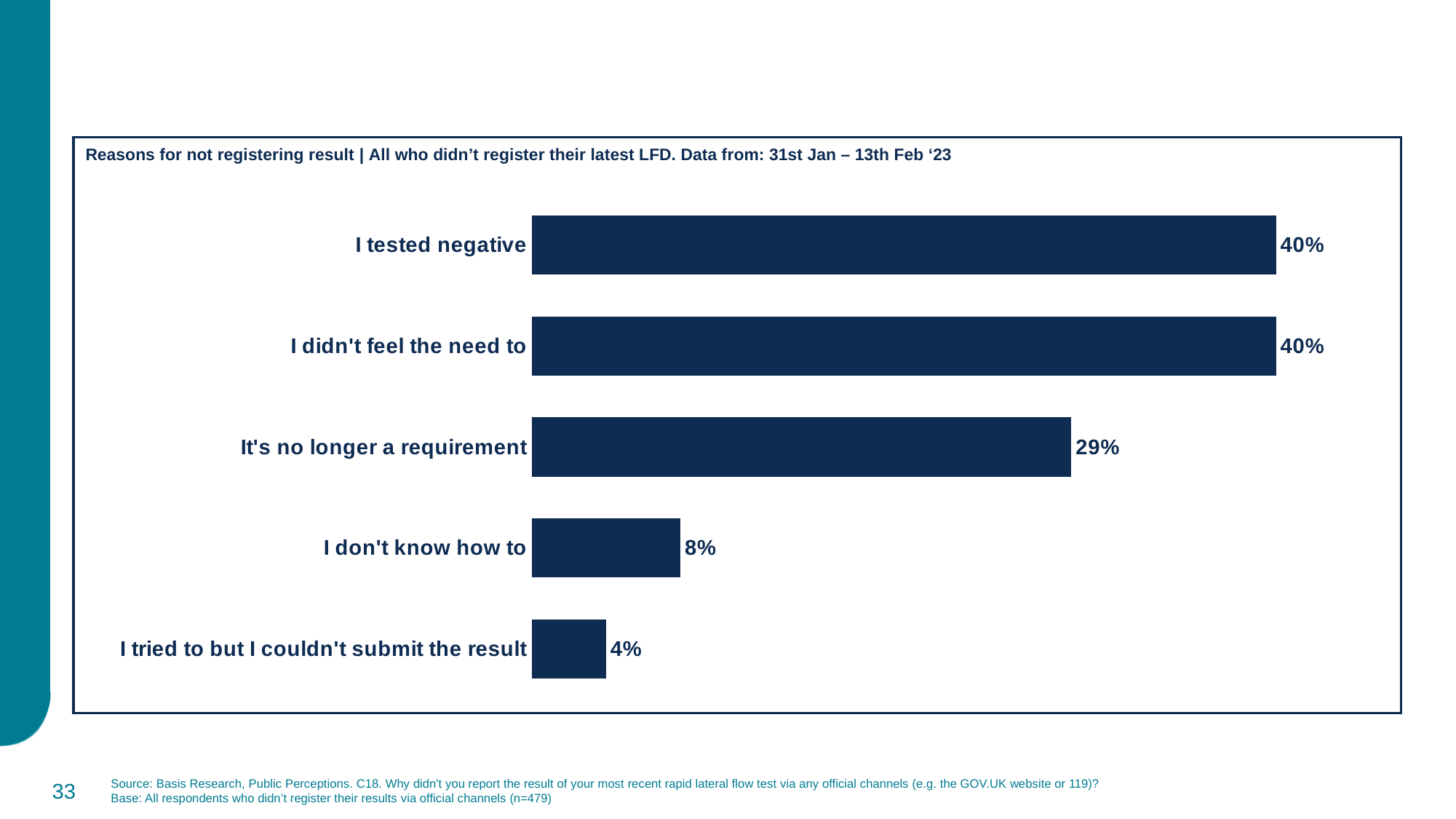
Which is larger: "It's no longer a requirement" or "I don't know how to"? It's no longer a requirement What percentage said "I don't know how to"? 8% What is the difference between "I don't know how to" and "I tried to but I couldn't submit the result"? 4% Do the values rise or fall going from the top bar to the bottom bar? Fall What is the value for "It's no longer a requirement"? 29% What is the difference between "I didn't feel the need to" and "It's no longer a requirement"? 11% How many reasons are shown in the chart? 5 What kind of chart is shown on the slide? Bar chart Which reason has the lowest percentage? I tried to but I couldn't submit the result What is the value for "I tried to but I couldn't submit the result"? 4% What percentage of respondents gave "I tested negative" as a reason for not registering their result? 40% What is the base size (n) stated for the chart? n=479